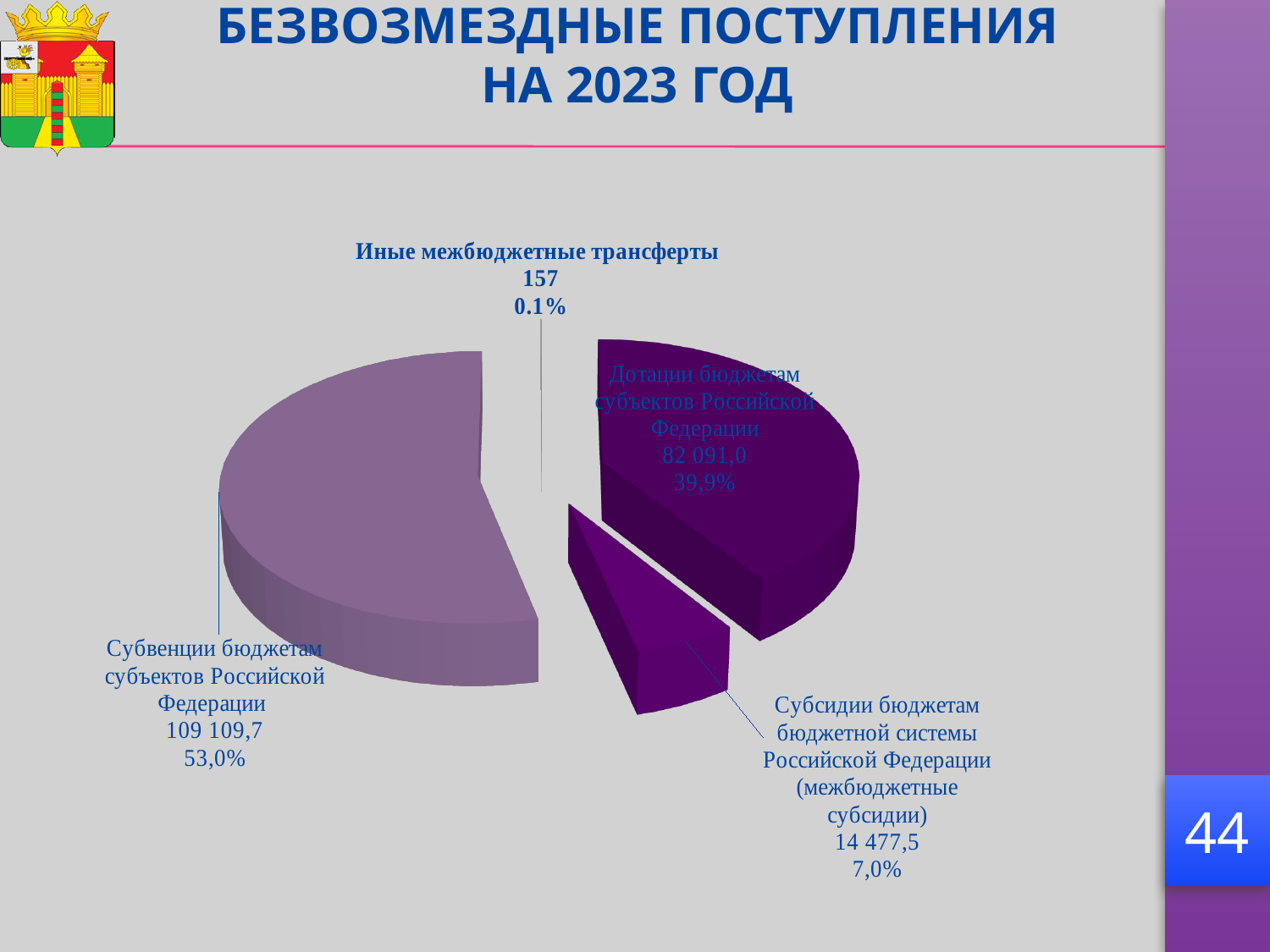
Which is larger: Дотации бюджетам субъектов Российской Федерации or Субсидии бюджетам бюджетной системы Российской Федерации (межбюджетные субсидии)? Дотации бюджетам субъектов Российской Федерации What is the title of the slide containing the chart? БЕЗВОЗМЕЗДНЫЕ ПОСТУПЛЕНИЯ НА 2023 ГОД Which category has the smallest slice of the pie? Иные межбюджетные трансферты What share of the pie is Иные межбюджетные трансферты? 0.1% What share of the pie is Дотации бюджетам субъектов Российской Федерации? 39,9% How many slices does the pie chart have? 4 What is the value shown for Субсидии бюджетам бюджетной системы Российской Федерации (межбюджетные субсидии)? 14 477,5 What share of the pie is Субвенции бюджетам субъектов Российской Федерации? 53,0% What is the value shown for Субвенции бюджетам субъектов Российской Федерации? 109 109,7 What type of chart is shown on the slide? Pie chart Which category has the largest slice of the pie? Субвенции бюджетам субъектов Российской Федерации What is the value shown for Дотации бюджетам субъектов Российской Федерации? 82 091,0